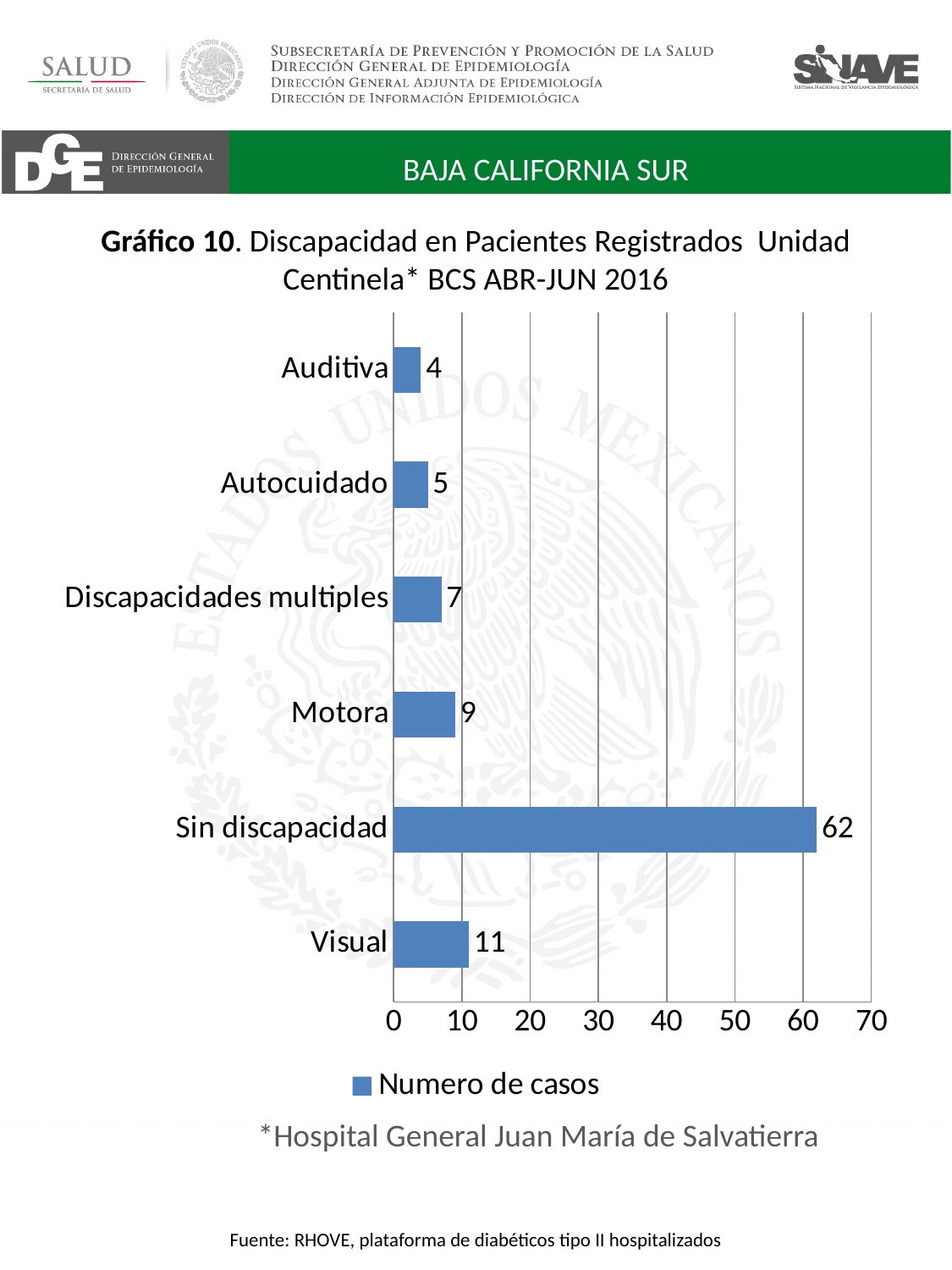
What is the number of cases for Auditiva? 4 Which category has the lowest number of cases? Auditiva Is the value for Sin discapacidad greater or less than 50? greater How many series does the legend list? 1 What is the legend entry of the chart? Numero de casos What is the number of cases for Visual? 11 Which has more cases, Discapacidades multiples or Autocuidado? Discapacidades multiples How many categories are shown in the chart? 6 Which category has the highest number of cases? Sin discapacidad What is the difference between the number of cases for Sin discapacidad and Visual? 51 What is the number of cases for Motora? 9 What kind of chart is shown on the slide? bar chart